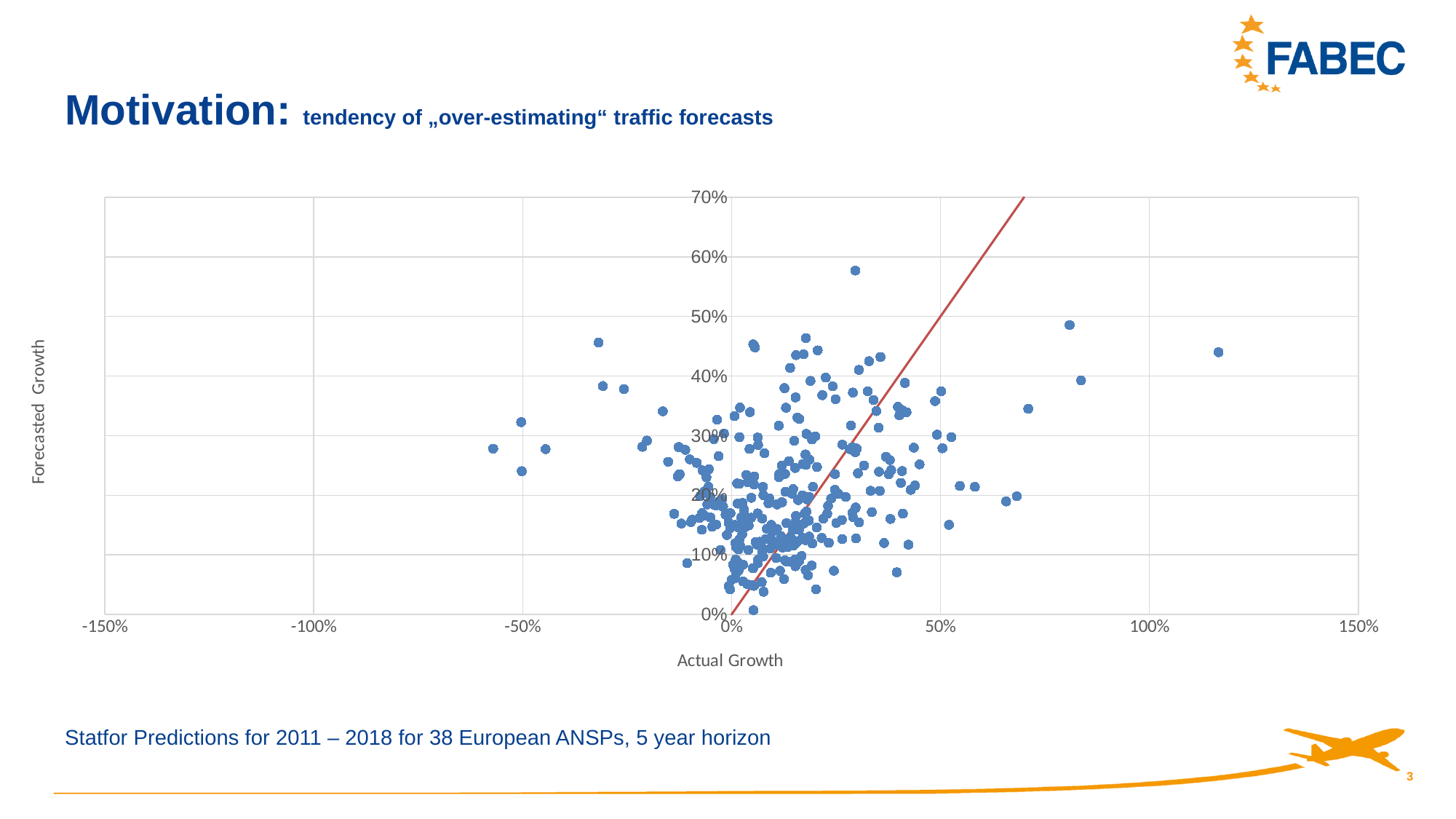
Is the actual growth of the leftmost point in the chart greater or less than -50%? less Is the forecasted growth of the leftmost point in the chart greater or less than 20%? greater Is the forecasted growth of the highest point in the chart greater or less than 60%? less What is the label of the horizontal axis of the chart? Actual Growth What kind of chart is shown on the slide? scatter plot What is the label of the vertical axis of the chart? Forecasted Growth